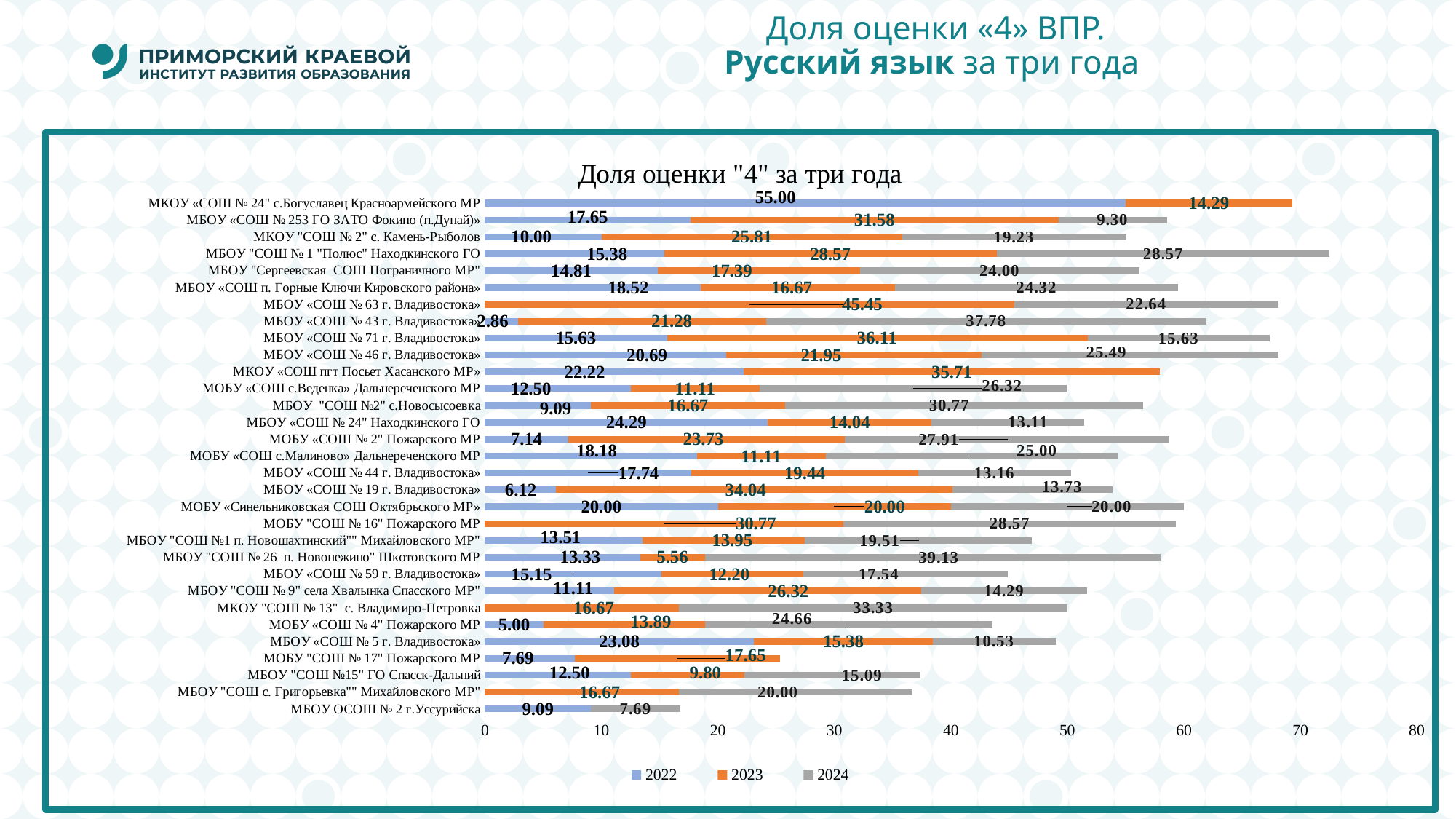
What is the 2024 value for МБОУ "СОШ № 26 п. Новонежино" Шкотовского МР? 39.13 What is the difference between the 2023 and 2022 values for МБОУ «СОШ № 19 г. Владивостока»? 27.92 How many series does the legend list? 3 What is the 2022 value for МКОУ «СОШ № 24" с.Богуславец Красноармейского МР? 55.00 Which school has the lowest 2022 value among those with a 2022 label? МБОУ «СОШ № 43 г. Владивостока» What is the 2023 value for МБОУ «СОШ № 253 ГО ЗАТО Фокино (п.Дунай)»? 31.58 What is the title of the chart? Доля оценки "4" за три года Which is larger for МБОУ «СОШ № 71 г. Владивостока»: the 2023 value or the 2024 value? 2023 Which school has the highest 2022 value? МКОУ «СОШ № 24" с.Богуславец Красноармейского МР How many schools (categories) are shown on the chart? 31 What is the total of the stacked bar for МОБУ «Синельниковская СОШ Октябрьского МР»? 60.00 What kind of chart is shown on the slide? Stacked bar chart